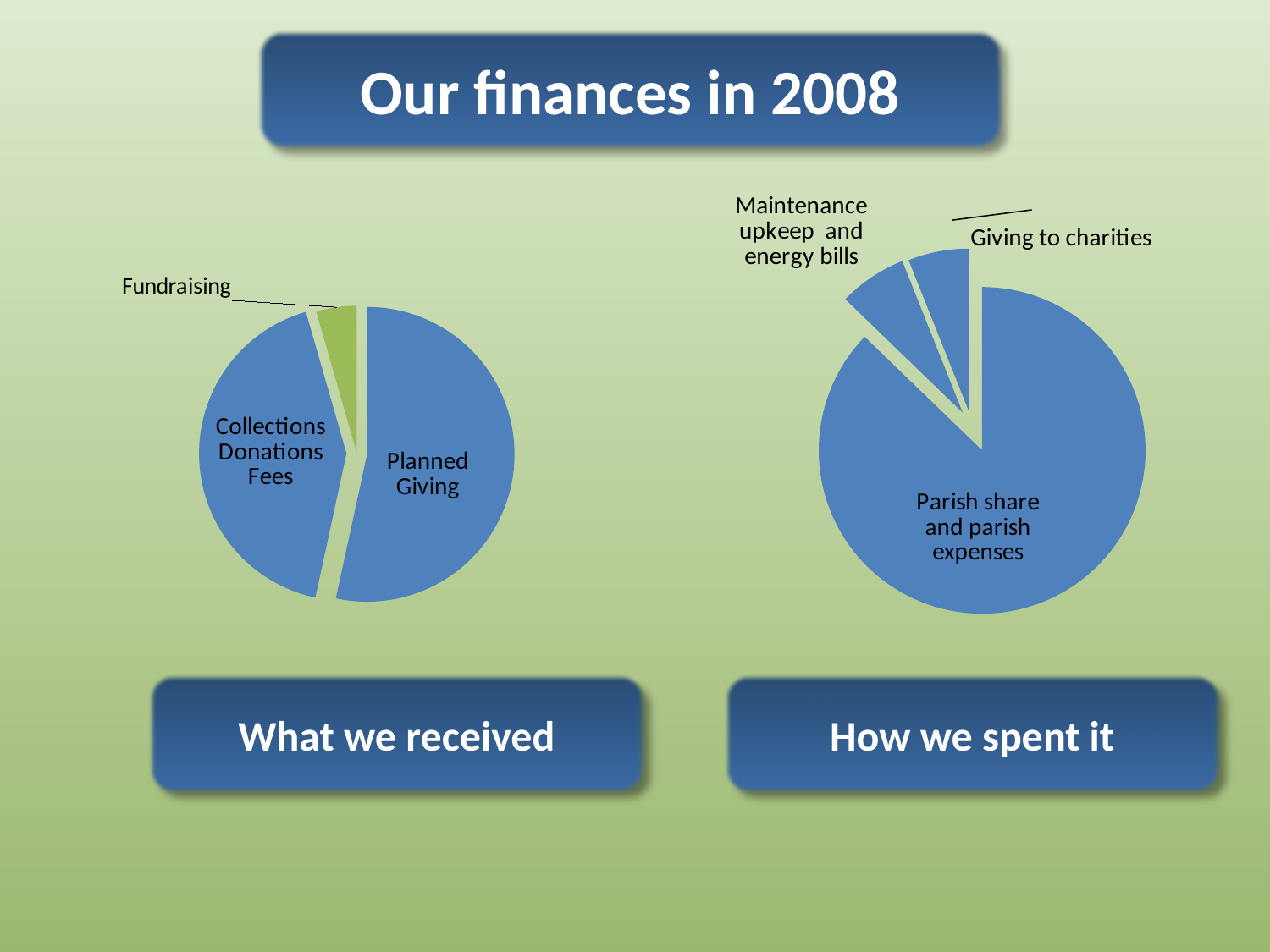
In the "How we spent it" chart, which category is the smallest slice? Giving to charities In the "What we received" chart, which is larger: Planned Giving or Collections Donations Fees? Planned Giving What kind of chart is used in the "What we received" chart? Pie chart In the "What we received" chart, how many slices does the pie have? 3 In the "How we spent it" chart, which category is the largest slice? Parish share and parish expenses In the "How we spent it" chart, how many slices does the pie have? 3 In the "What we received" chart, what colour is the Fundraising slice? Green In the "What we received" chart, which category is the smallest slice? Fundraising What is the title shown at the top of the slide above the two charts? Our finances in 2008 In the "How we spent it" chart, which is larger: Maintenance upkeep and energy bills or Giving to charities? Maintenance upkeep and energy bills In the "What we received" chart, which category is the largest slice? Planned Giving What kind of chart is used in the "How we spent it" chart? Pie chart